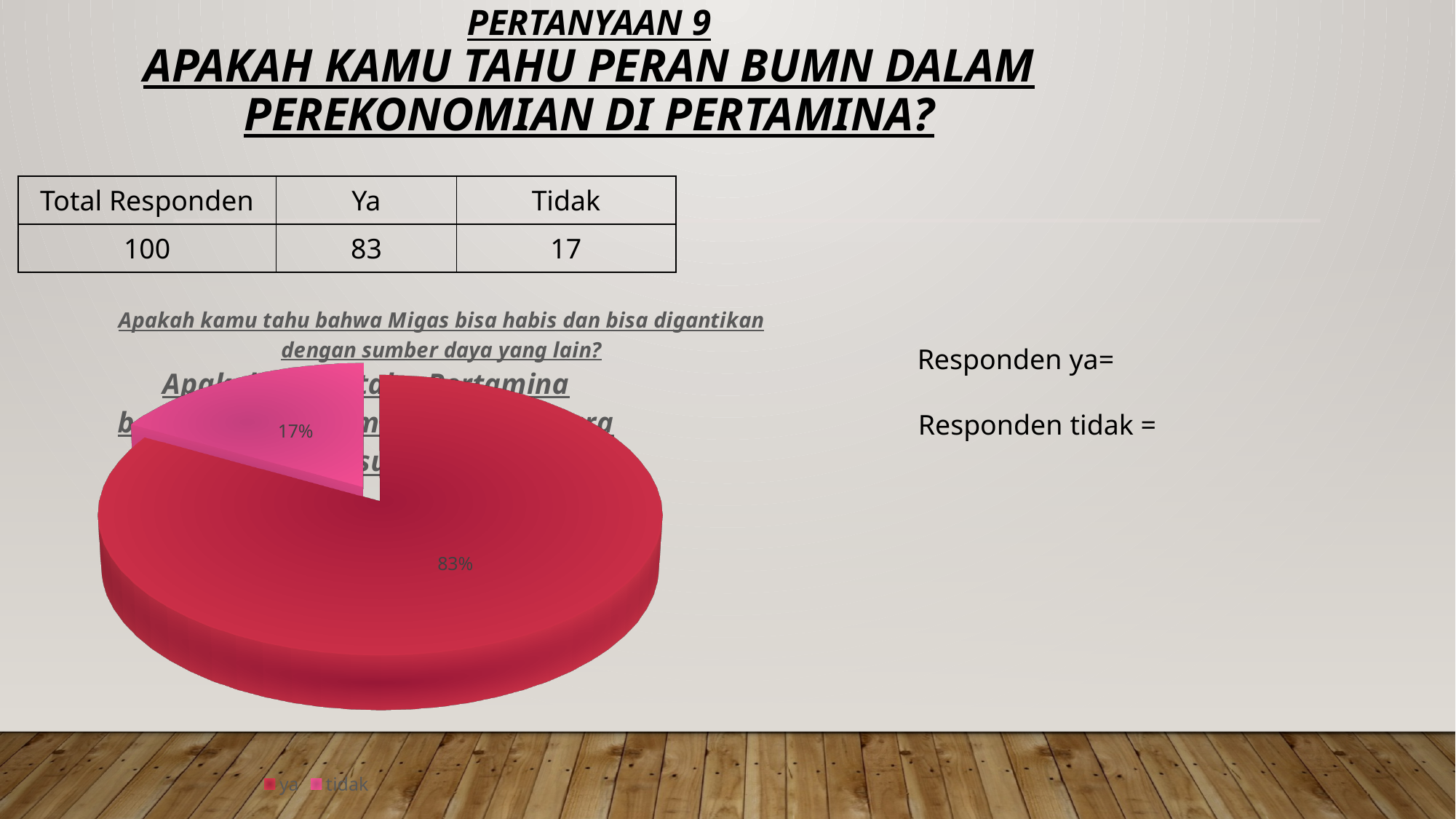
Which slice of the pie chart is the largest? ya What percentage of the pie chart is labelled for the "tidak" slice? 17% What kind of chart is shown on the slide? Pie chart What percentage of the pie chart is labelled for the "ya" slice? 83% How many slices does the pie chart have? 2 Which is larger in the pie chart, the "ya" slice or the "tidak" slice? ya Which slice of the pie chart is the smallest? tidak How many entries does the legend of the pie chart list? 2 What are the two legend entries of the pie chart? ya and tidak Which legend entry is shown in the lighter pink colour in the pie chart? tidak By how many percentage points does the "ya" slice exceed the "tidak" slice in the pie chart? 66 percentage points What share of the pie does the "tidak" slice represent? 17%